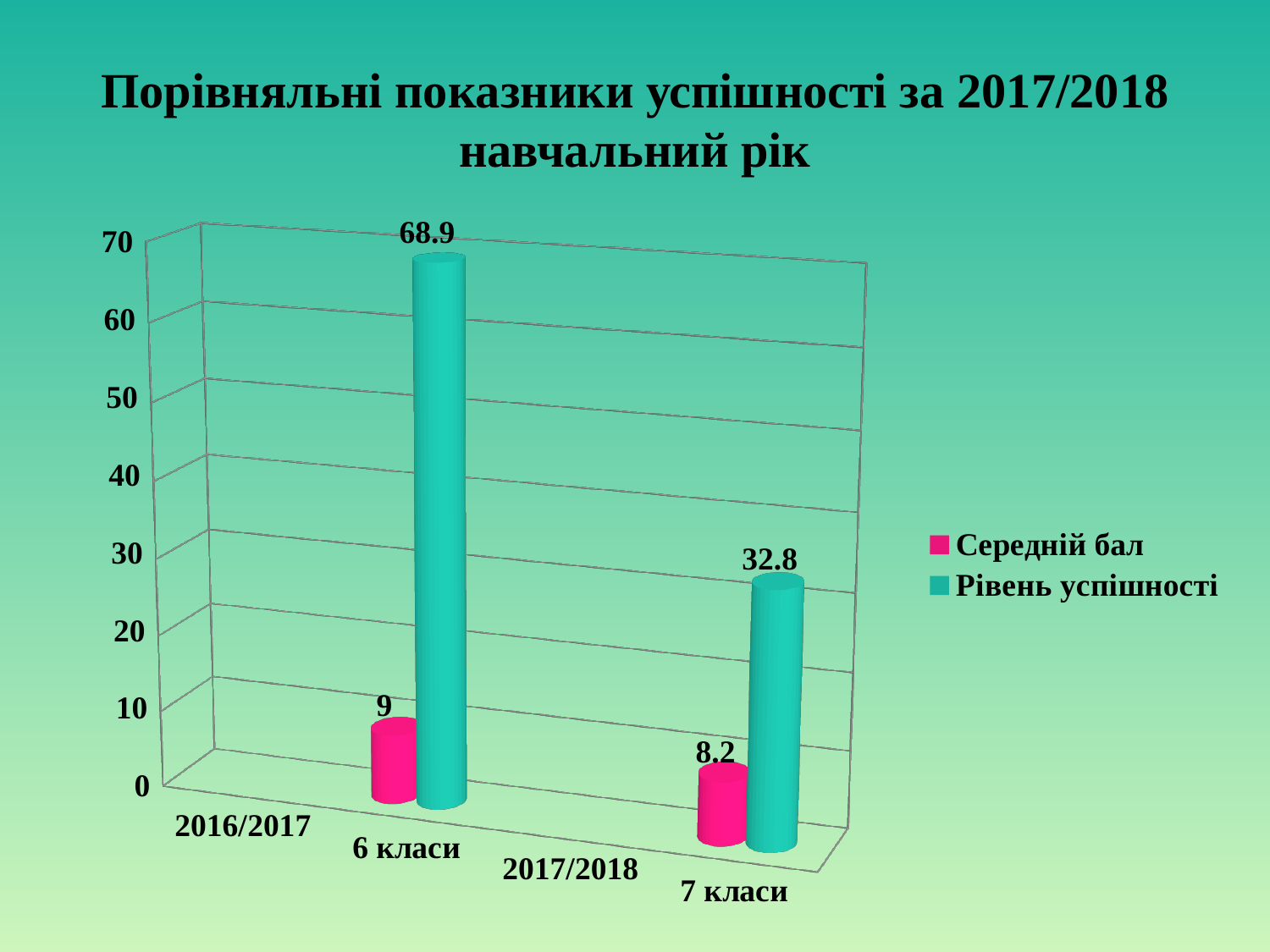
How many series does the legend list? 2 Which category has the highest Рівень успішності? 2016/2017 (6 класи) What is the difference in Рівень успішності between 2016/2017 (6 класи) and 2017/2018 (7 класи)? 36.1 What is the value of Рівень успішності for 2017/2018 (7 класи)? 32.8 What is the value of Середній бал for 2017/2018 (7 класи)? 8.2 Which is larger: Середній бал for 6 класи or Середній бал for 7 класи? 6 класи What is the value of Рівень успішності for 2016/2017 (6 класи)? 68.9 Is the Рівень успішності for 2017/2018 (7 класи) greater or less than 40? less What is the value of Середній бал for 2016/2017 (6 класи)? 9 Which category has the lowest Середній бал? 2017/2018 (7 класи) What kind of chart is shown on the slide? bar chart Which colour represents Рівень успішності in the legend? teal